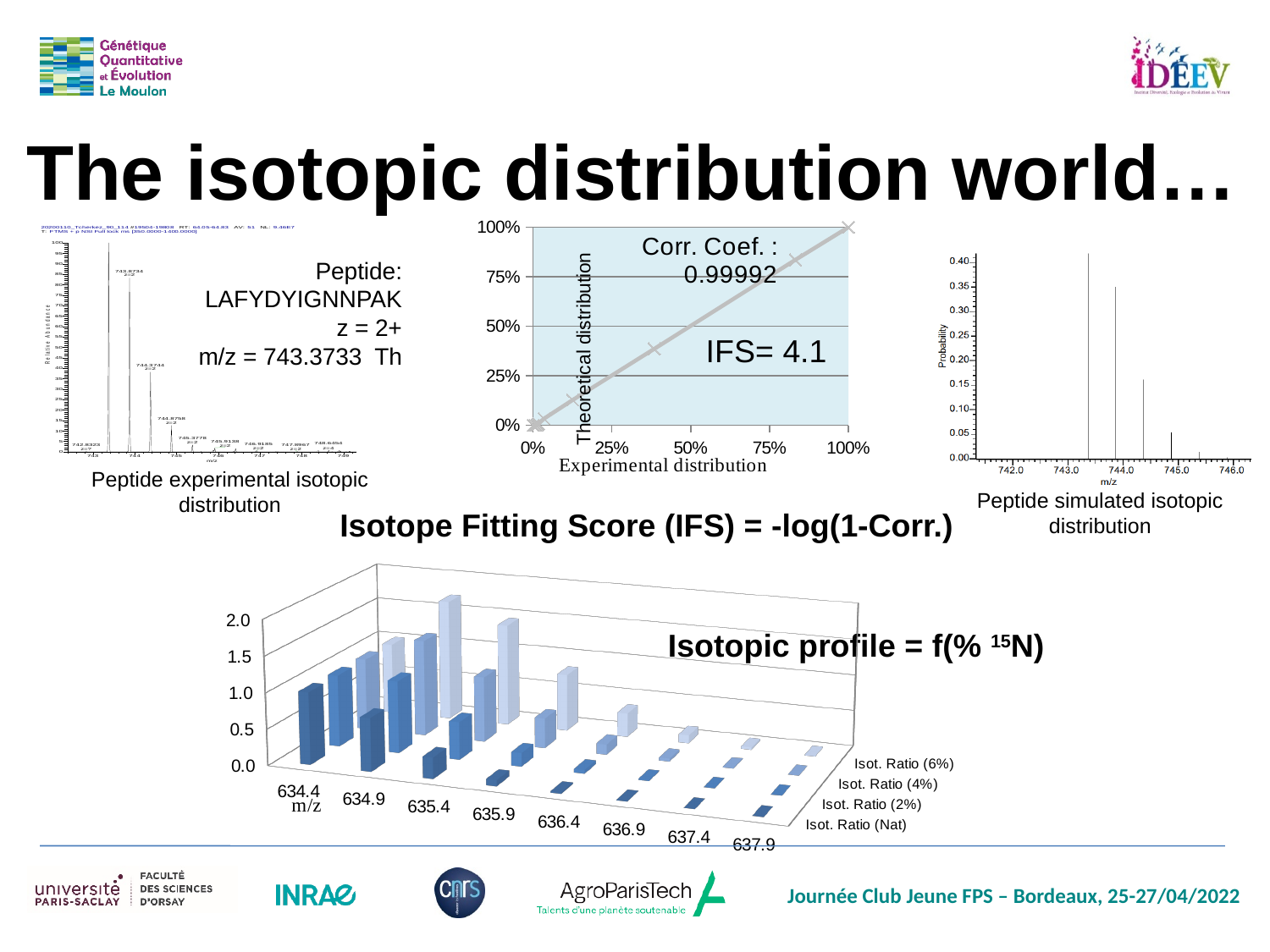
In the 3D bar chart at the bottom of the slide, what is the first m/z category on the x axis? 634.4 In the 3D bar chart at the bottom of the slide, is the value for Isot. Ratio (Nat) at 637.9 greater or less than 0.5? less In the scatter chart of theoretical versus experimental distribution, what correlation coefficient is printed on the chart? 0.99992 What kind of chart is the one at the bottom of the slide showing Isot. Ratio series? bar chart In the 3D bar chart at the bottom of the slide, do the Isot. Ratio (Nat) values rise or fall as m/z increases from 634.4 to 637.9? fall In the chart titled 'Peptide simulated isotopic distribution', is the tallest peak greater or less than 0.35? greater In the scatter chart of theoretical versus experimental distribution, what IFS value is printed on the chart? 4.1 In the 3D bar chart at the bottom of the slide, how many m/z categories are shown along the x axis? 8 In the chart titled 'Peptide simulated isotopic distribution', is the peak near 744.4 m/z greater or less than 0.20? less In the 3D bar chart at the bottom of the slide, what is the highest tick value shown on the vertical axis? 2.0 In the chart titled 'Peptide simulated isotopic distribution', what is the label of the y axis? Probability